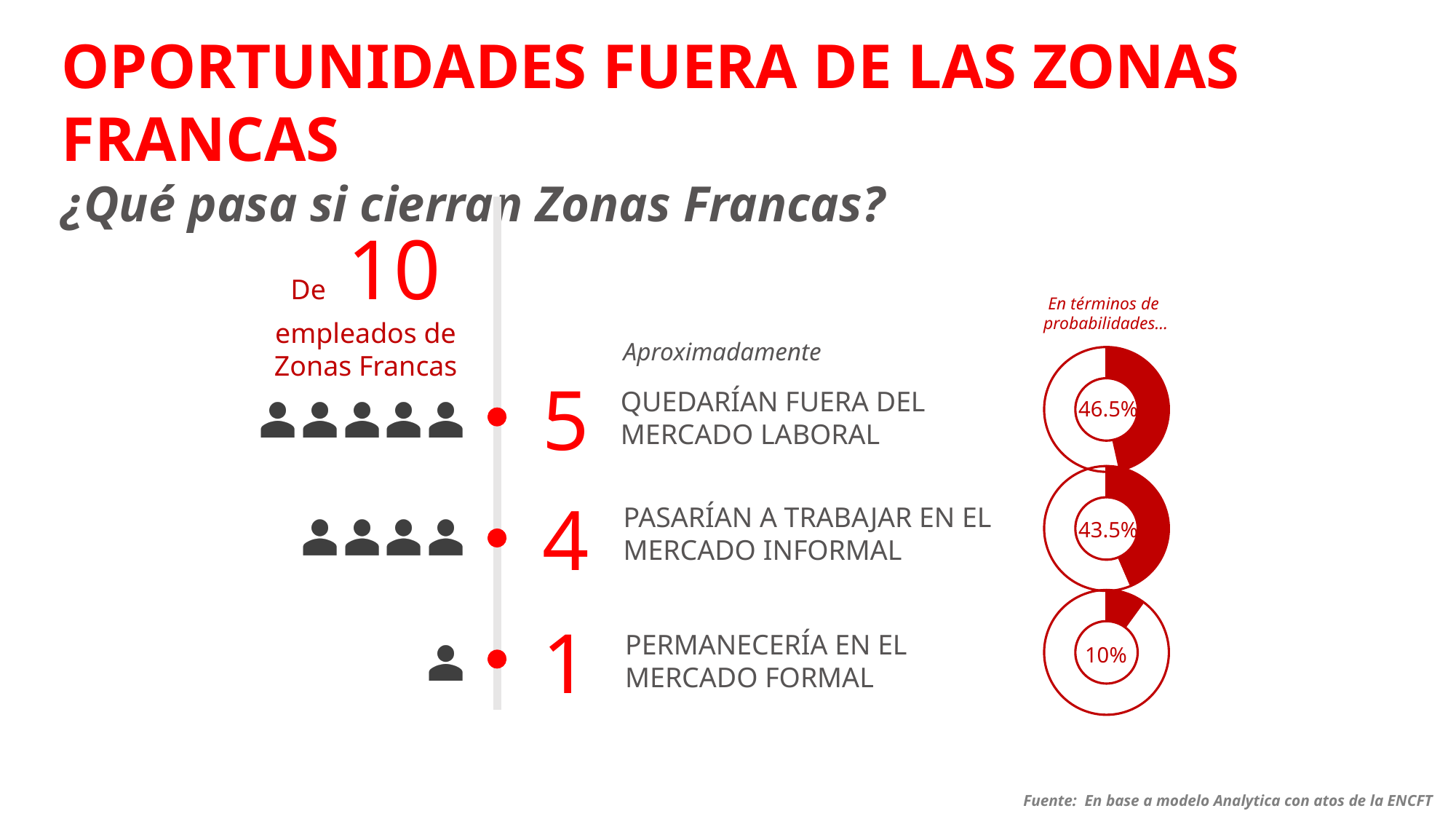
Out of 10 Zonas Francas employees, how many would remain in the formal market according to the infographic? 1 How many donut charts are shown on the slide? 3 Which of the three outcomes has the highest probability in the donut charts? Quedarían fuera del mercado laboral Which is larger: the probability of staying in the formal market or the probability of moving to the informal market? Moving to the informal market (43.5%) What probability is shown in the middle donut chart for 'Pasarían a trabajar en el mercado informal'? 43.5% What is the difference in percentage points between the top donut (46.5%) and the middle donut (43.5%)? 3 Which of the three outcomes has the lowest probability in the donut charts? Permanecería en el mercado formal What probability is shown in the top donut chart for 'Quedarían fuera del mercado laboral'? 46.5% What is the label above the donut charts on the right? En términos de probabilidades... What probability is shown in the bottom donut chart for 'Permanecería en el mercado formal'? 10% What type of chart is used to show the probabilities on the right side of the slide? Donut (pie) chart What is the difference in percentage points between the middle donut (43.5%) and the bottom donut (10%)? 33.5